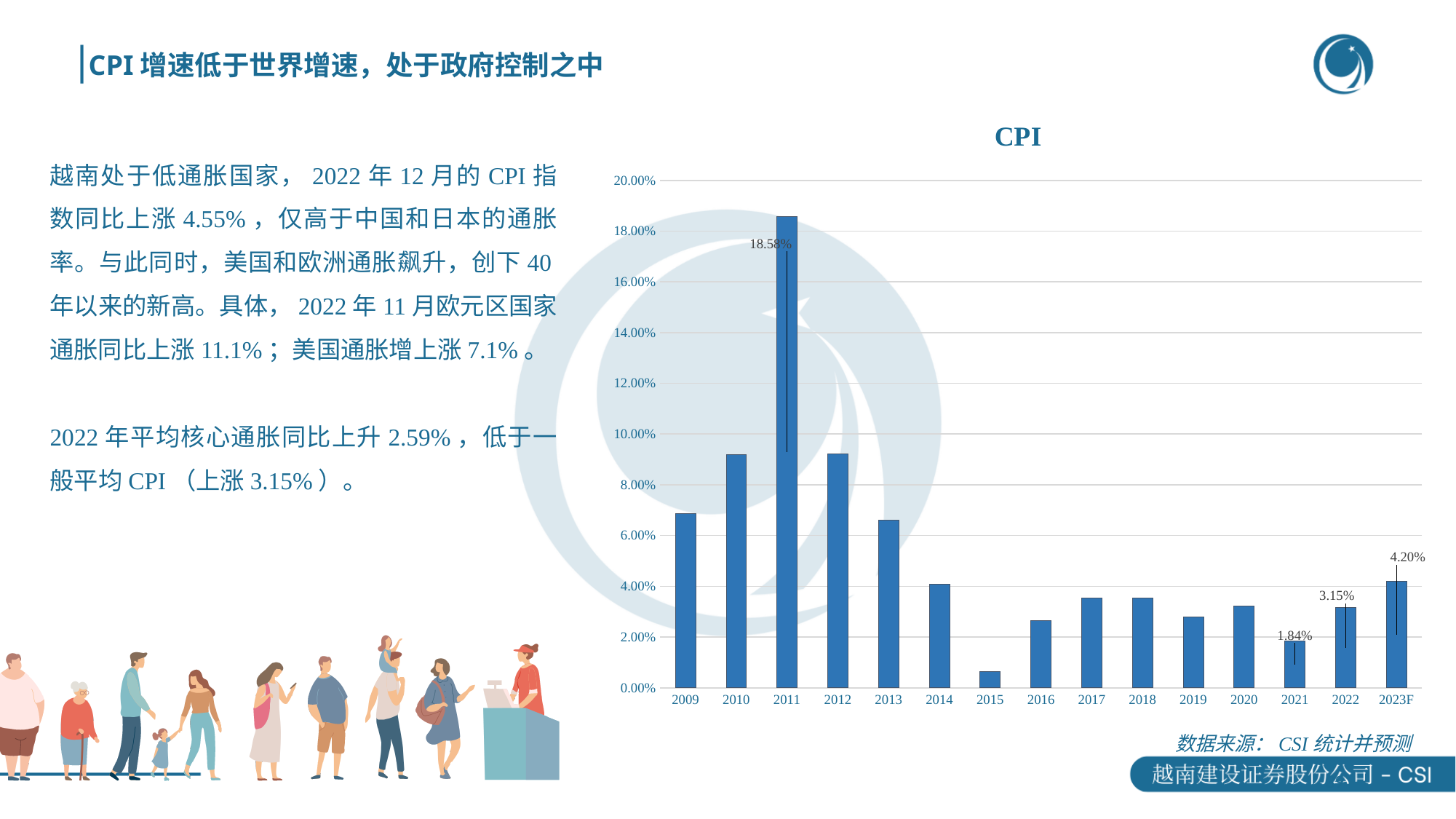
What type of chart is shown on the slide? bar chart What is the CPI value for 2023F? 4.20% Which is larger, the CPI value for 2013 or for 2014? 2013 What is the difference between the CPI values for 2022 and 2021? 1.31% What is the title of the chart? CPI Which year has the lowest CPI value? 2015 What is the CPI value for 2022? 3.15% What is the CPI value for 2021? 1.84% What is the CPI value for 2011? 18.58% Is the CPI value for 2010 greater or less than 8.00%? greater Which year has the highest CPI value? 2011 How many years are shown on the x axis of the CPI chart? 15